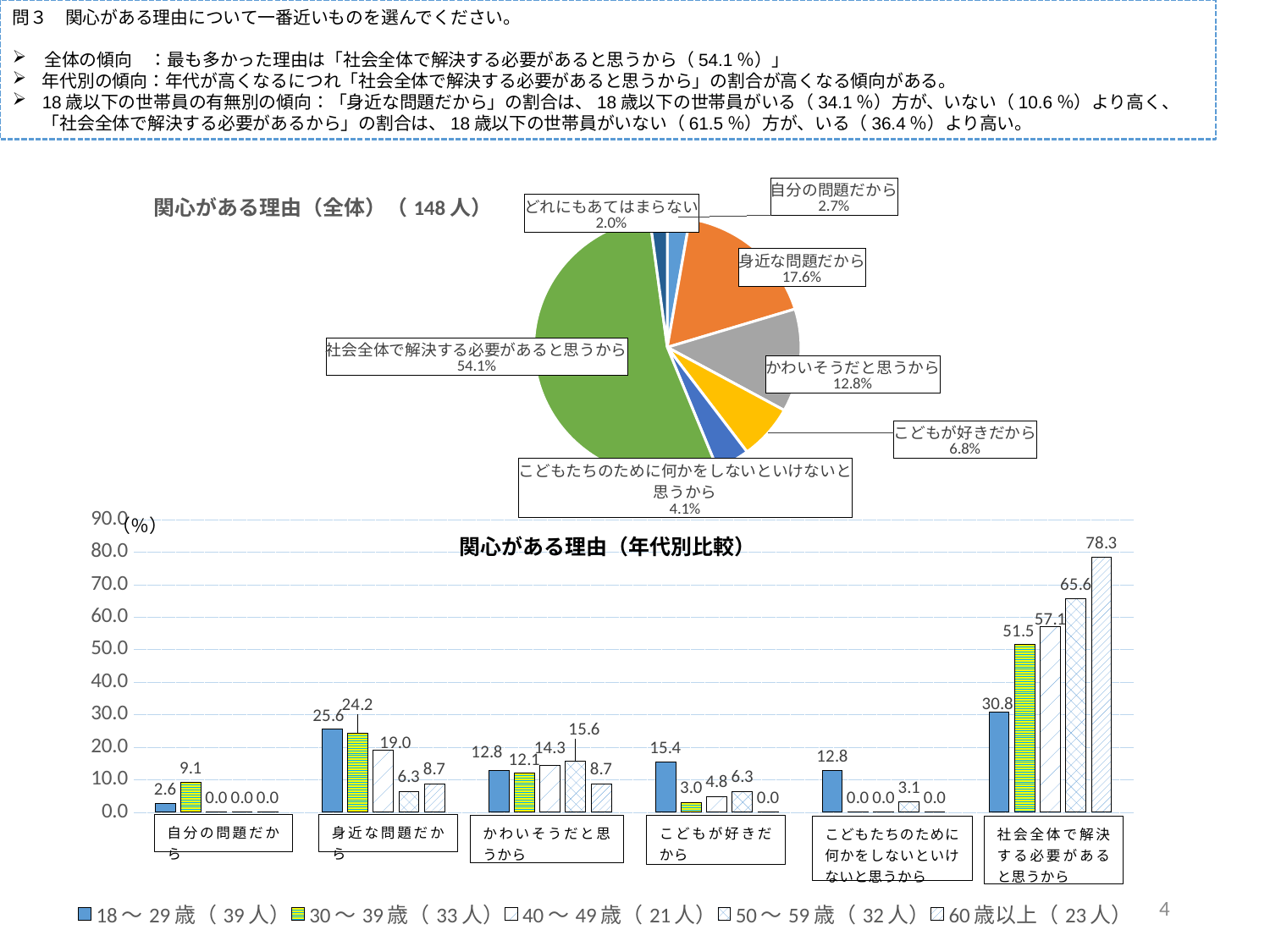
円グラフ「関心がある理由（全体）」で、「身近な問題だから」の割合はいくらですか。 17.6% 棒グラフ「関心がある理由（年代別比較）」で、「こどもが好きだから」の18～29歳と30～39歳では、どちらの値が大きいですか。 18～29歳 棒グラフ「関心がある理由（年代別比較）」で、「身近な問題だから」の18～29歳の値はいくらですか。 25.6 円グラフ「関心がある理由（全体）」には、いくつの項目がありますか。 7 円グラフ「関心がある理由（全体）」で、「かわいそうだと思うから」と「こどもが好きだから」の割合の差はいくらですか。 6.0% 棒グラフ「関心がある理由（年代別比較）」で、「社会全体で解決する必要があると思うから」の50～59歳と18～29歳の値の差はいくらですか。 34.8 円グラフ「関心がある理由（全体）」で、最も割合が小さい理由はどれですか。 どれにもあてはまらない 棒グラフ「関心がある理由（年代別比較）」で、「社会全体で解決する必要があると思うから」の値は年代が高くなるにつれて上がっていますか、下がっていますか。 上がっている 棒グラフ「関心がある理由（年代別比較）」の凡例には、いくつの年代区分がありますか。 5 スライド下部のグラフはどの種類のグラフですか。 棒グラフ 円グラフ「関心がある理由（全体）」で、「社会全体で解決する必要があると思うから」の割合はいくらですか。 54.1% 棒グラフ「関心がある理由（年代別比較）」で、「社会全体で解決する必要があると思うから」の60歳以上の値はいくらですか。 78.3